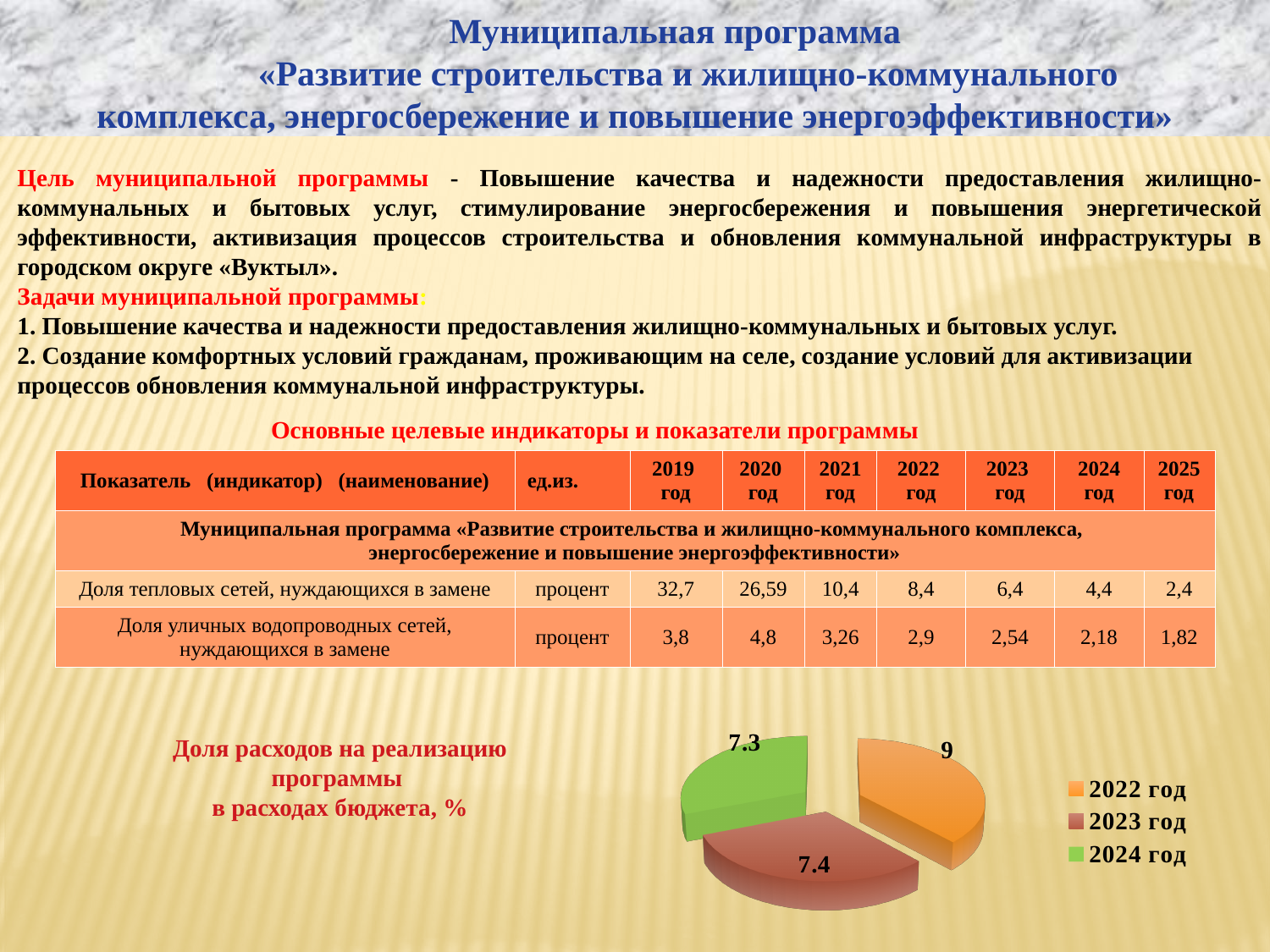
What is the value for 2023 год in the pie chart? 7.4 Which year has the smallest slice in the pie chart? 2024 год What is the difference between the values for 2023 год and 2024 год in the pie chart? 0.1 What is the value for 2022 год in the pie chart? 9 Which is larger in the pie chart, the value for 2023 год or 2024 год? 2023 год How many entries does the pie chart legend list? 3 What is the difference between the values for 2022 год and 2023 год in the pie chart? 1.6 What colour is the slice for 2024 год in the pie chart? green How many slices does the pie chart have? 3 What is the value for 2024 год in the pie chart? 7.3 What type of chart is shown on the slide? pie chart Which year has the largest slice in the pie chart? 2022 год